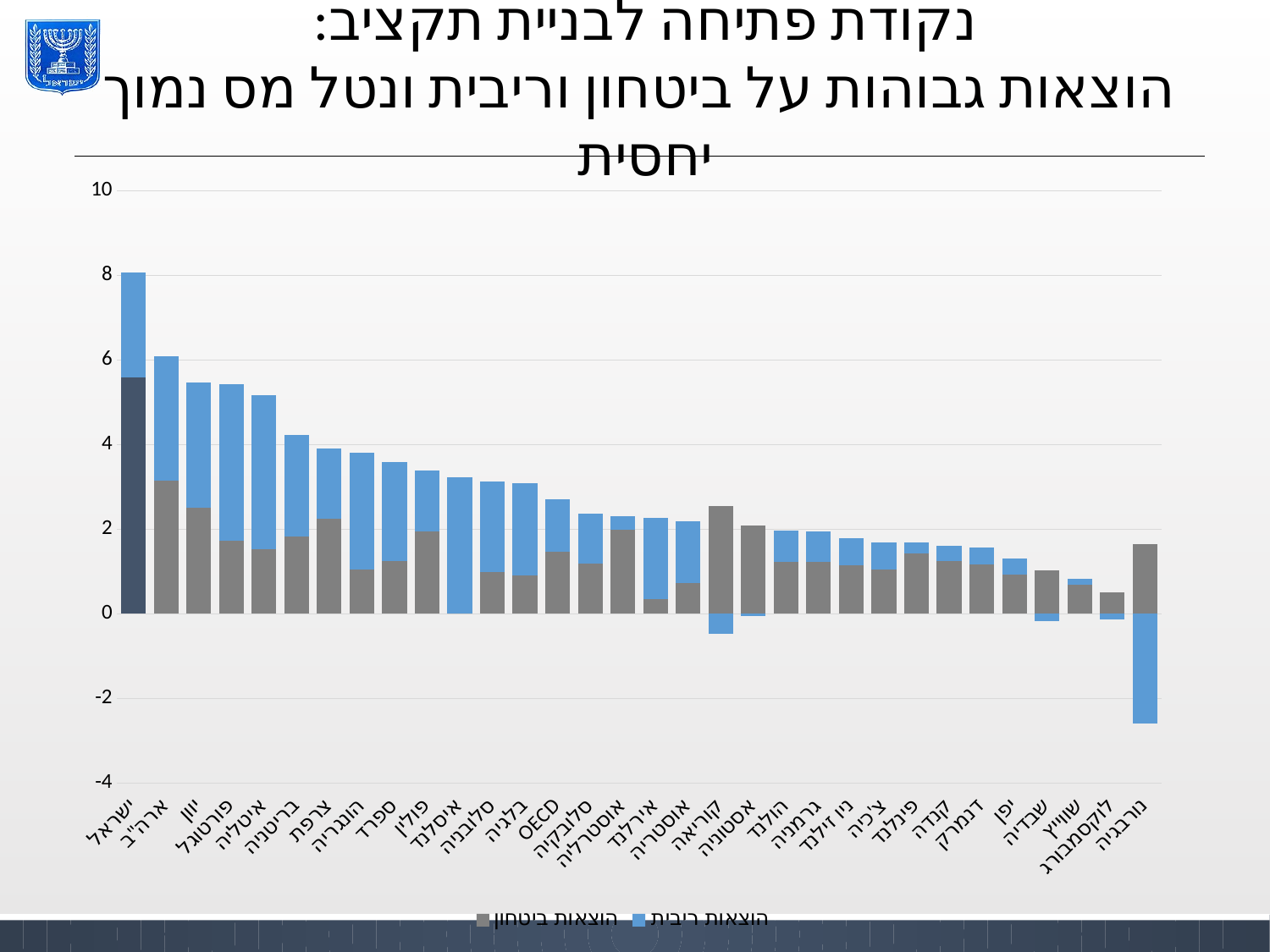
Which category has the tallest stacked bar? ישראל How many series does the legend list? 2 Which has the taller stacked bar, יוון or יפן? יוון Which has the taller stacked bar, ישראל or ארה"ב? ישראל Is the blue segment for נורבגיה greater or less than -2? less What kind of chart is shown on the slide? bar chart Is the total stacked value for לוקסמבורג greater or less than 1? less Do the stacked bar totals generally rise or fall from left to right along the x axis? fall Is the total stacked value for יוון greater or less than 4? greater How many countries/categories are plotted along the x axis? 32